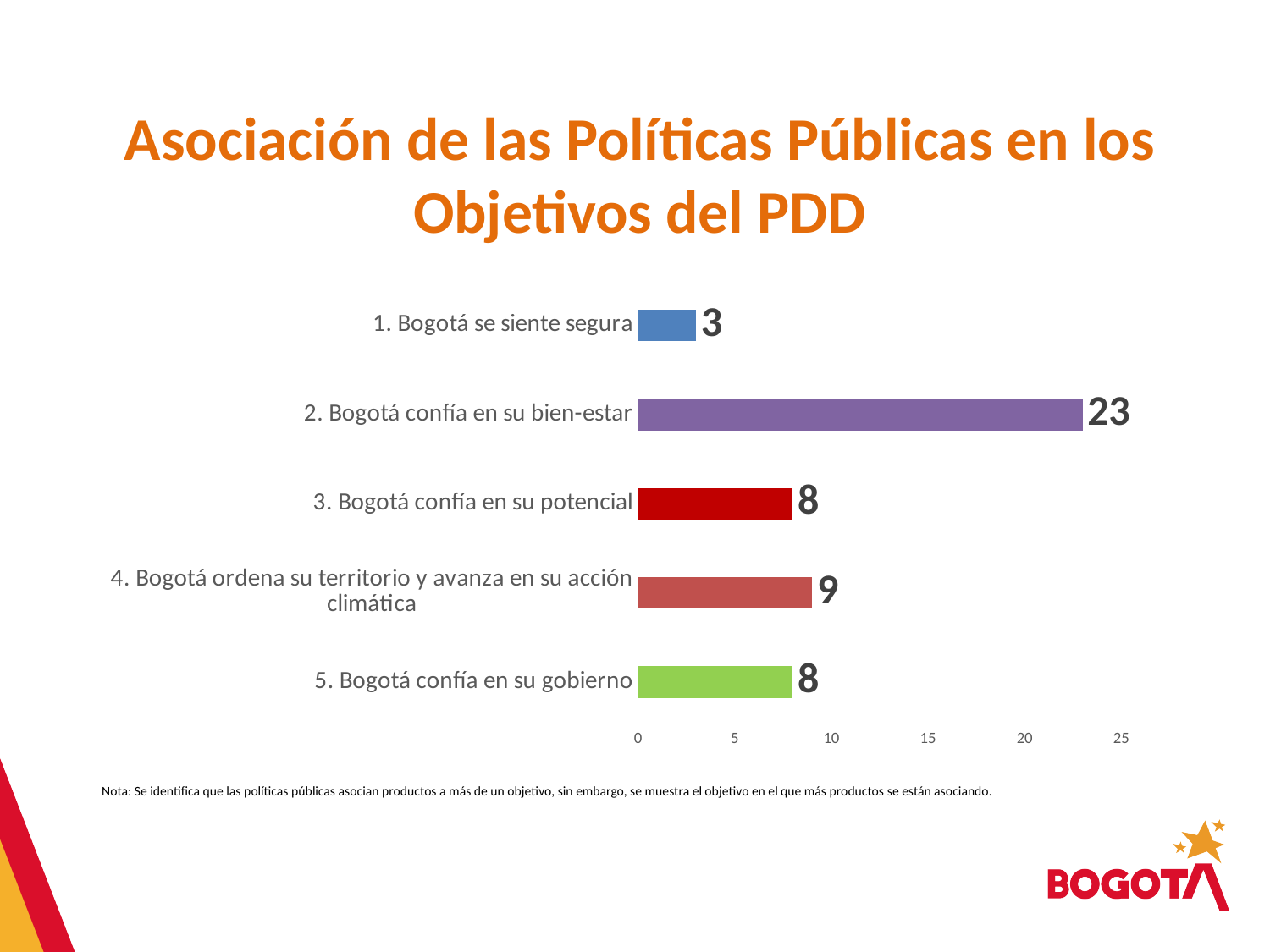
What is the difference between the values for "2. Bogotá confía en su bien-estar" and "1. Bogotá se siente segura"? 20 What is the difference between the values for "4. Bogotá ordena su territorio y avanza en su acción climática" and "3. Bogotá confía en su potencial"? 1 How many categories are shown in the chart? 5 What kind of chart is shown on the slide? Bar chart What is the title of the slide containing the chart? Asociación de las Políticas Públicas en los Objetivos del PDD Which category has the lowest value? 1. Bogotá se siente segura Is the value for "2. Bogotá confía en su bien-estar" greater or less than 20? greater Which category has the highest value? 2. Bogotá confía en su bien-estar What is the value for "2. Bogotá confía en su bien-estar"? 23 What is the value for "1. Bogotá se siente segura"? 3 What is the value for "4. Bogotá ordena su territorio y avanza en su acción climática"? 9 Which is larger, the value for "3. Bogotá confía en su potencial" or the value for "1. Bogotá se siente segura"? 3. Bogotá confía en su potencial